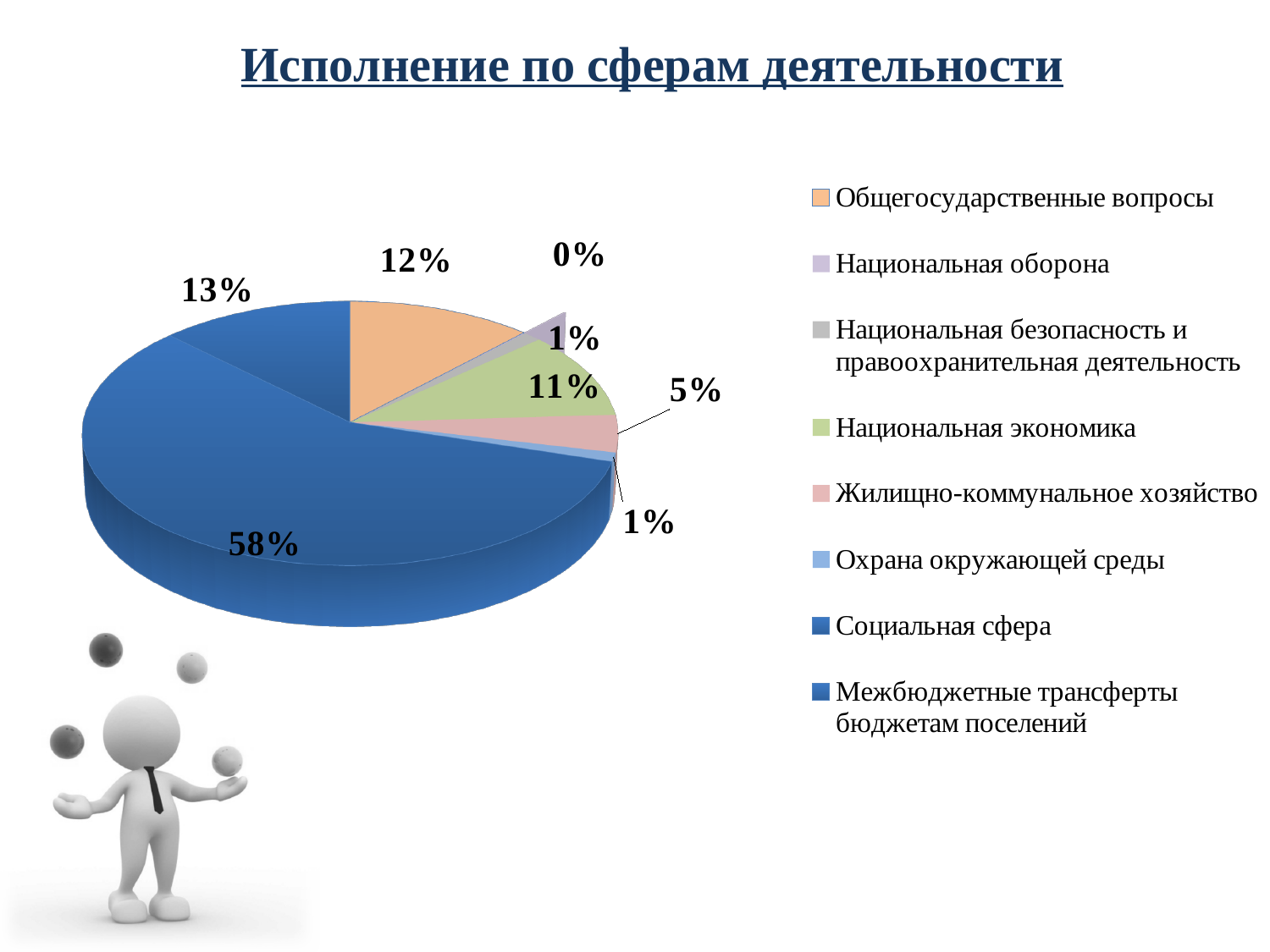
What is the value for Общегосударственные вопросы? 12% What share of the pie does Социальная сфера have? 58% How many categories does the legend list? 8 What is the value for Межбюджетные трансферты бюджетам поселений? 13% What is the value for Жилищно-коммунальное хозяйство? 5% What is the value for Национальная экономика? 11% What colour is the slice for Национальная экономика? Green What is the difference between the shares of Социальная сфера and Межбюджетные трансферты бюджетам поселений? 45% What is the title of the chart? Исполнение по сферам деятельности Which category has the largest share of the pie? Социальная сфера Which is larger, the share for Общегосударственные вопросы or the share for Национальная экономика? Общегосударственные вопросы What kind of chart is shown on the slide? Pie chart